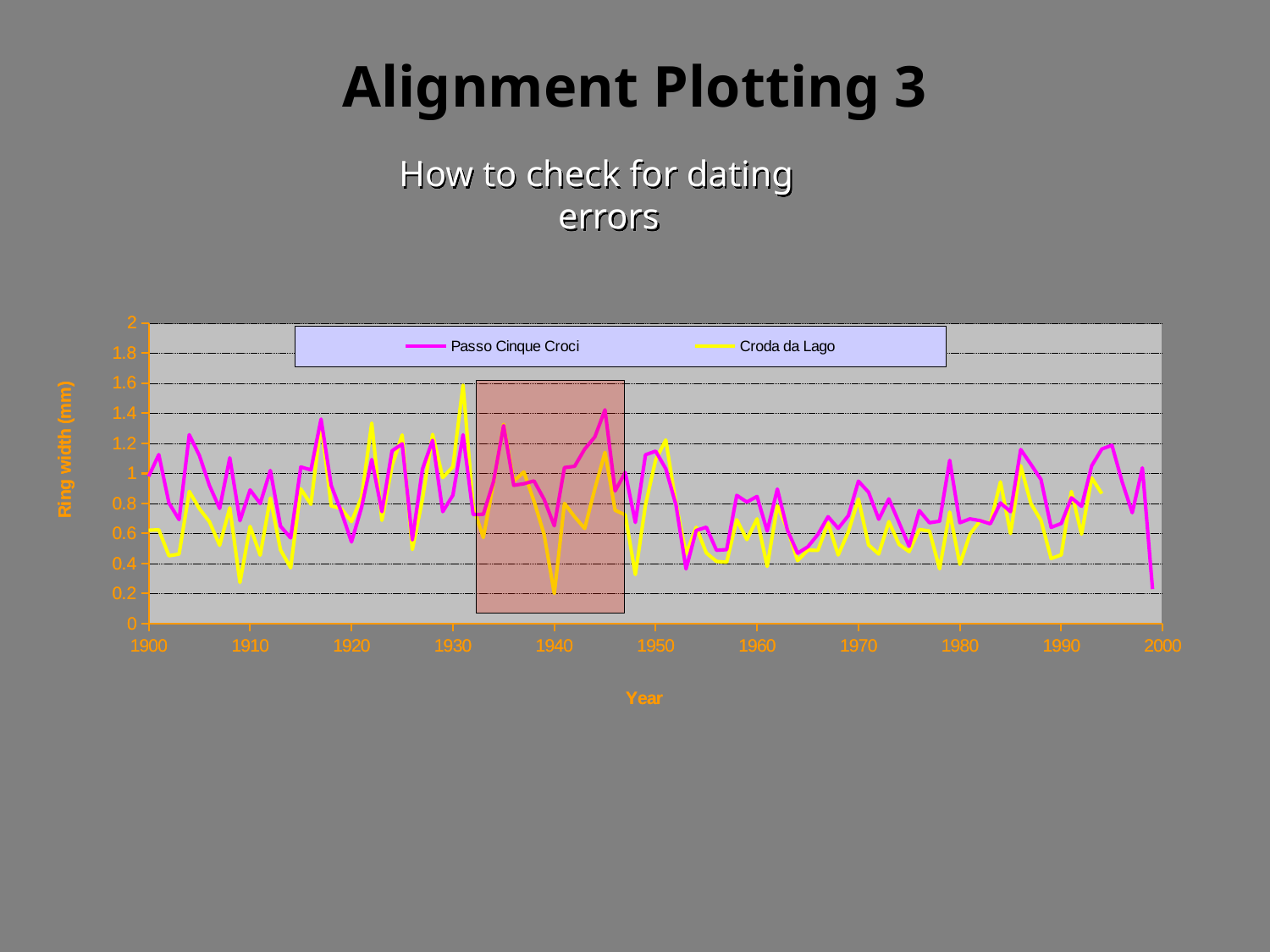
How many series does the legend list? 2 Is the lowest value reached by the Croda da Lago series greater or less than 0.4? less Is the highest value reached by the Croda da Lago series greater or less than 1.4? greater Is the highest value reached by the Passo Cinque Croci series greater or less than 1.2? greater What kind of chart is shown on the slide? line chart What is the title of the vertical axis? Ring width (mm) Which series reaches the higher peak value, Passo Cinque Croci or Croda da Lago? Croda da Lago Which series is drawn in yellow? Croda da Lago